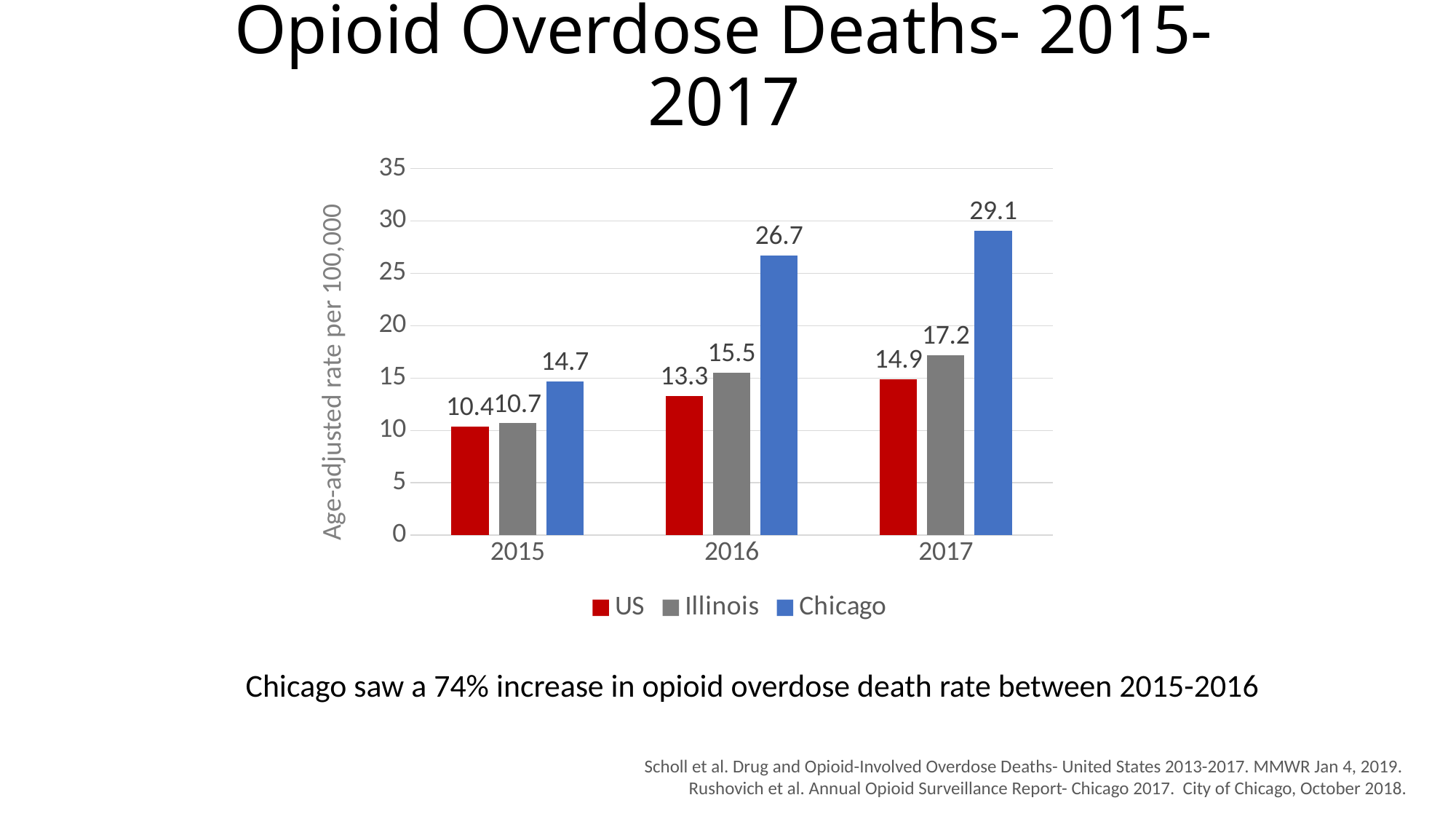
What was the age-adjusted opioid overdose death rate for the US in 2015? 10.4 Does the Chicago rate rise or fall from 2015 to 2017? Rise How many years are shown on the x axis? 3 How many series does the legend list? 3 Which series had the highest rate in 2016? Chicago What kind of chart is shown on the slide? Bar chart Which was larger in 2015, the US rate or the Illinois rate? Illinois What was the age-adjusted opioid overdose death rate for Illinois in 2016? 15.5 What is the difference between the Chicago rate and the US rate in 2017? 14.2 Which series had the lowest rate in 2017? US By how much did the Chicago rate increase from 2015 to 2016? 12 What was the age-adjusted opioid overdose death rate for Chicago in 2017? 29.1